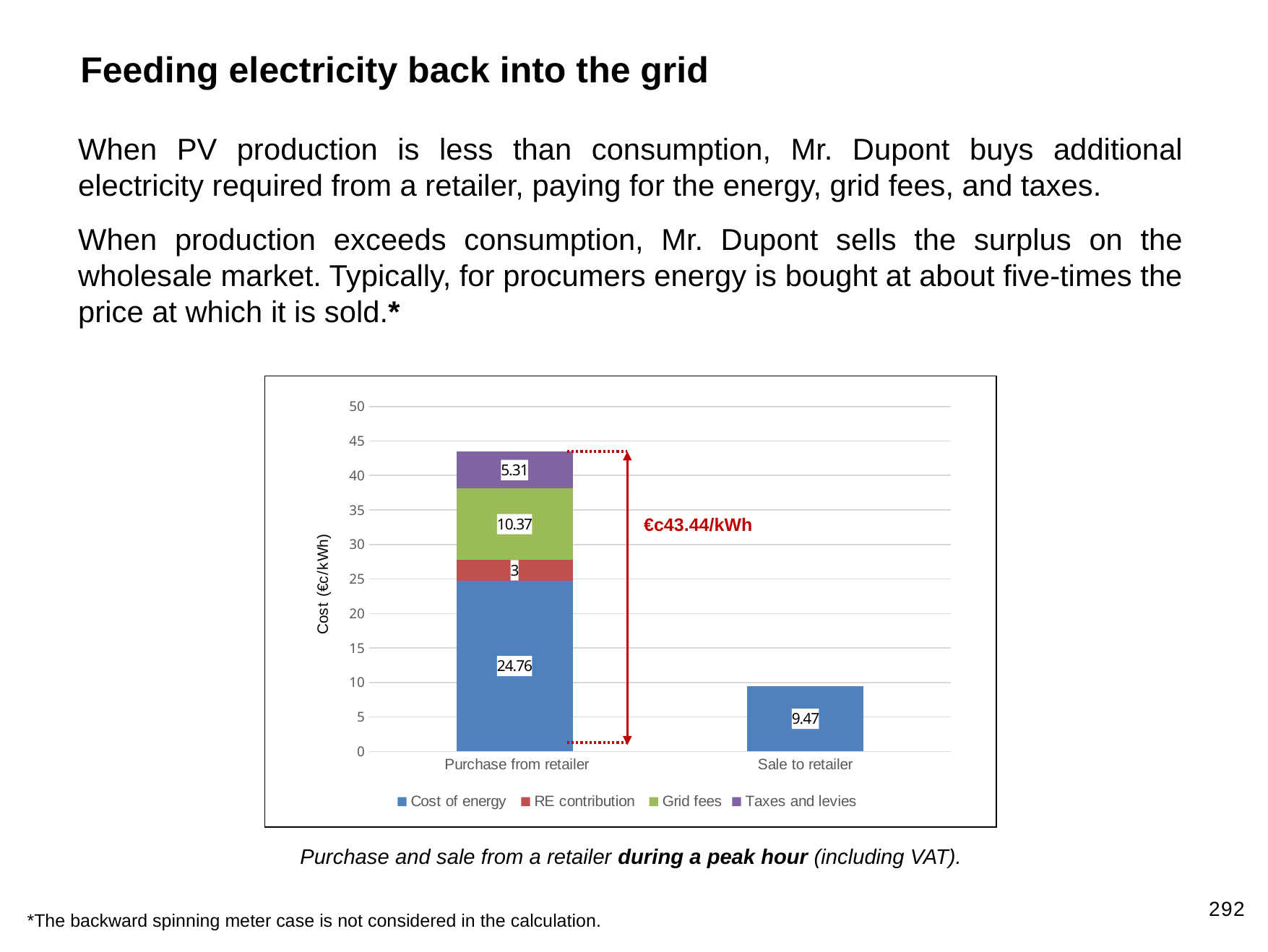
Which category has the taller bar, Purchase from retailer or Sale to retailer? Purchase from retailer How many categories are shown on the x axis? 2 What is the value shown for Sale to retailer? 9.47 What is the value of the Grid fees segment for Purchase from retailer? 10.37 What kind of chart is shown on the slide? Stacked bar chart What is the value of the Taxes and levies segment for Purchase from retailer? 5.31 How many series does the legend list? 4 Which segment of the Purchase from retailer bar is the smallest? RE contribution What is the value of the Cost of energy segment for Purchase from retailer? 24.76 What is the value of the RE contribution segment for Purchase from retailer? 3 What is the difference between the Cost of energy for Purchase from retailer and the value for Sale to retailer? 15.29 What is the total of the stacked bar for Purchase from retailer? 43.44